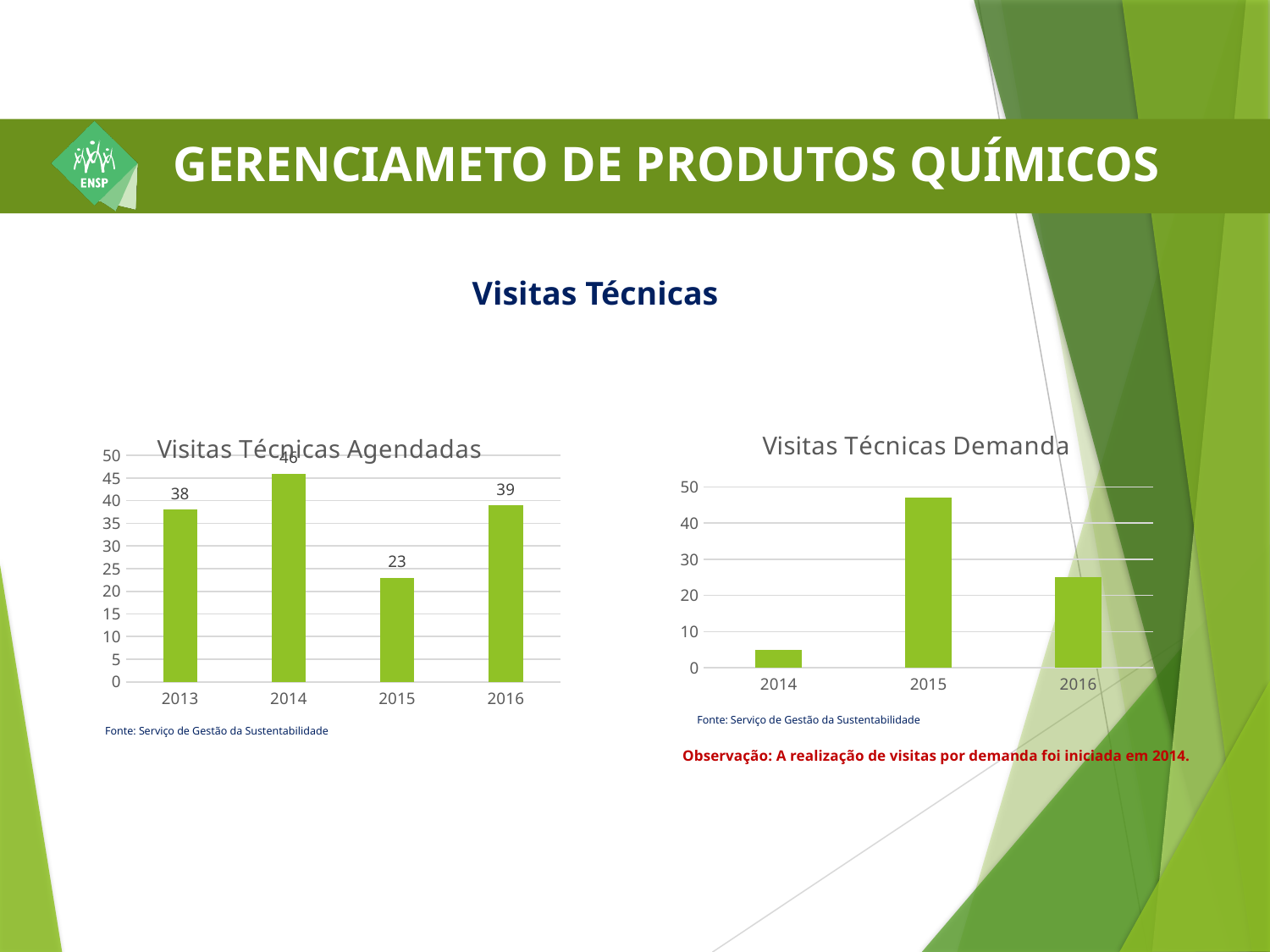
In the 'Visitas Técnicas Agendadas' chart, which year has the highest value? 2014 In the 'Visitas Técnicas Agendadas' chart, what is the value for 2013? 38 In the 'Visitas Técnicas Demanda' chart, is the value for 2014 greater or less than 10? less In the 'Visitas Técnicas Demanda' chart, which year has the lowest value? 2014 In the 'Visitas Técnicas Agendadas' chart, which year has the lowest value? 2015 In the 'Visitas Técnicas Agendadas' chart, how many years are shown on the x axis? 4 What kind of chart is the 'Visitas Técnicas Demanda' chart? Bar chart In the 'Visitas Técnicas Agendadas' chart, what is the value for 2016? 39 In the 'Visitas Técnicas Agendadas' chart, what is the difference between the values for 2016 and 2015? 16 In the 'Visitas Técnicas Demanda' chart, is the value for 2015 greater or less than 40? greater In the 'Visitas Técnicas Demanda' chart, which year has the highest value? 2015 In the 'Visitas Técnicas Agendadas' chart, what is the value for 2015? 23